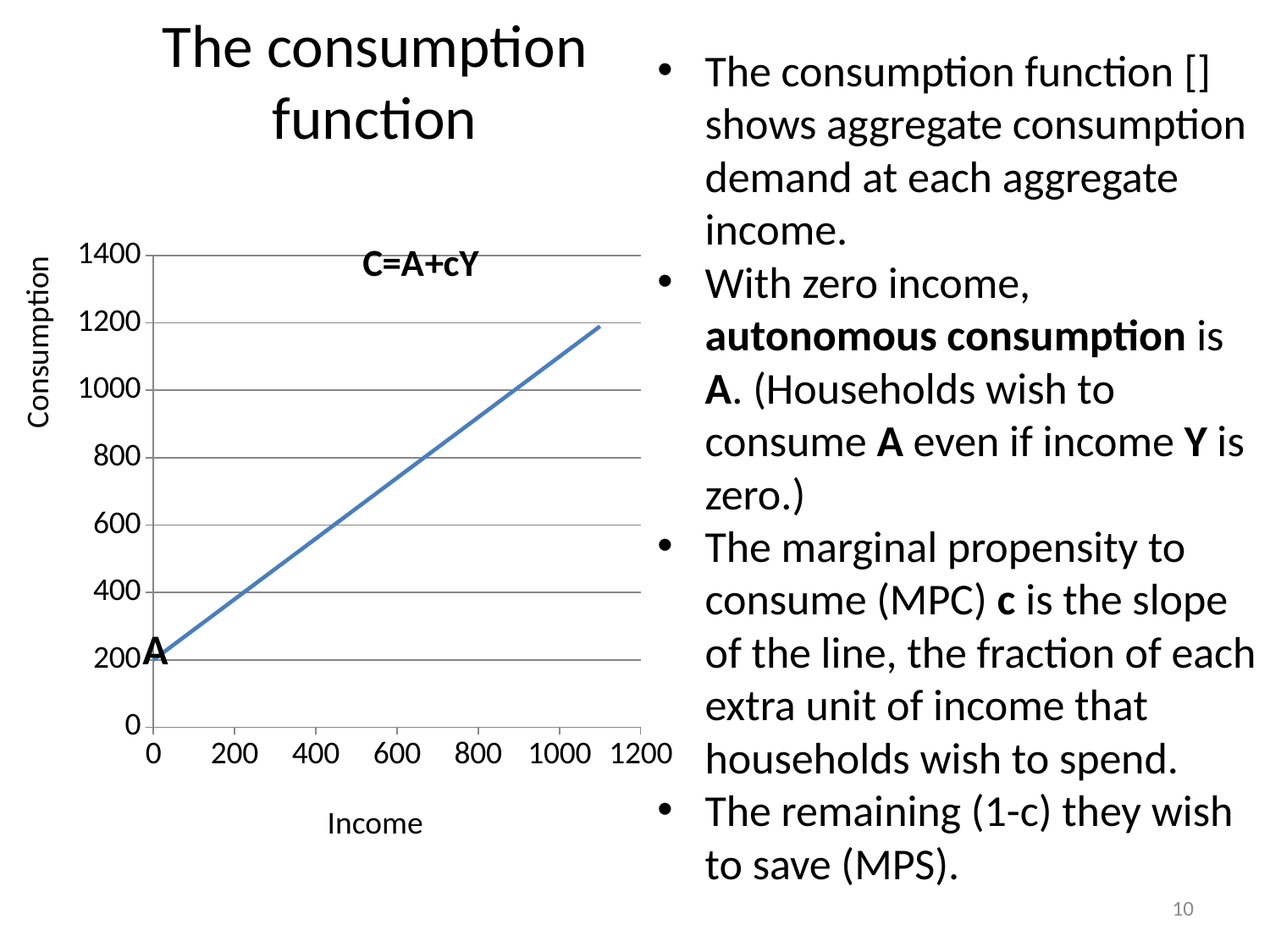
What is the value of consumption when income is 0? 200 Is the value of consumption at an income of 200 greater or less than 200? greater Is the value of consumption at an income of 400 greater or less than 400? greater Is the value of consumption at an income of 800 greater or less than 800? greater What is the label of the y axis of the chart? Consumption Is consumption higher at an income of 1000 or at an income of 200? 1000 What is the highest value shown on the y axis of the chart? 1400 Does consumption rise or fall as income increases along the x axis? rise What is the label of the x axis of the chart? Income What kind of chart is shown on the slide? line chart